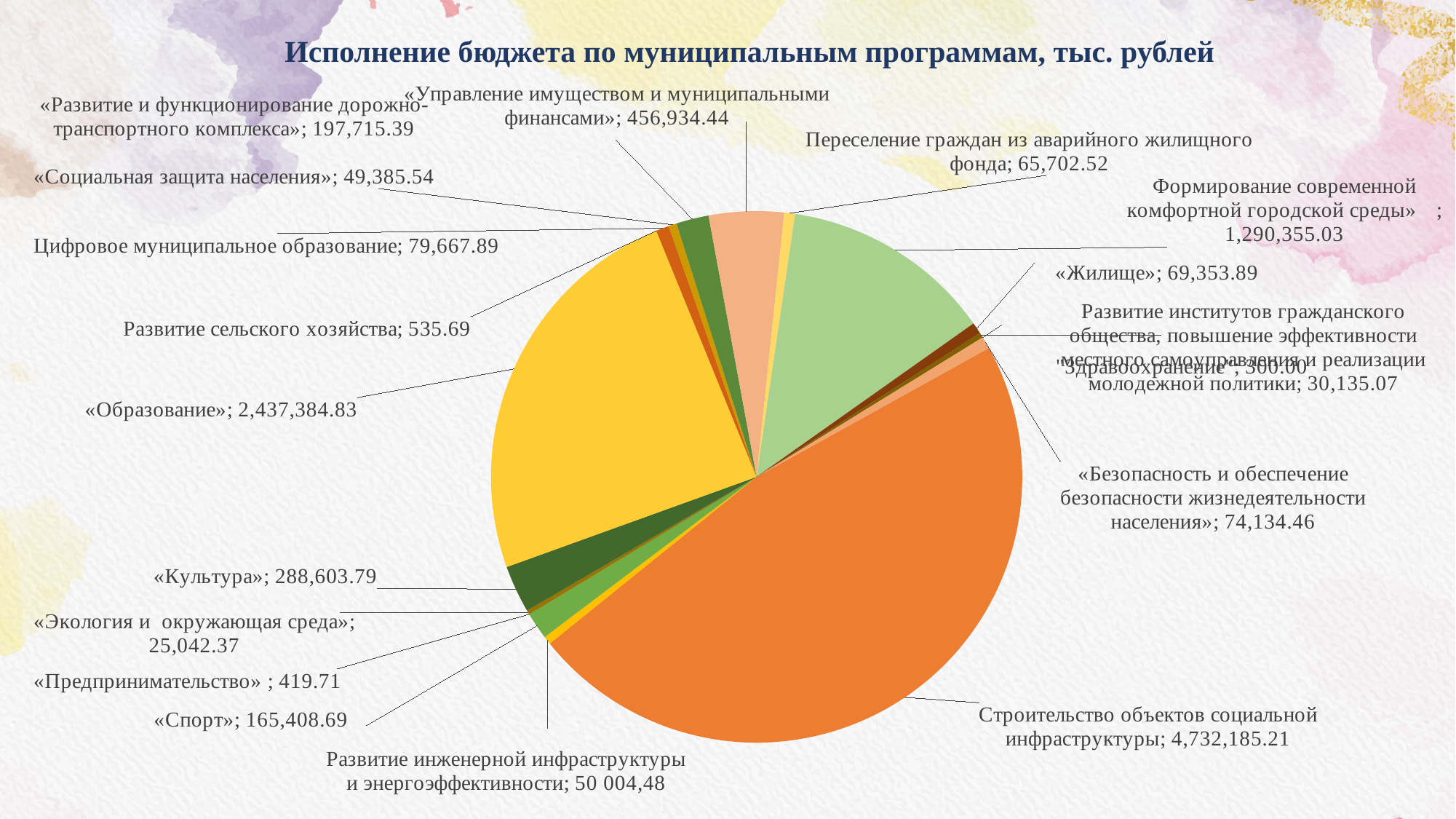
What is the difference between the values for «Образование» and «Культура»? 2,148,781.04 What is the value for «Управление имуществом и муниципальными финансами»? 456,934.44 Which is larger: the value for «Образование» or for Формирование современной комфортной городской среды? «Образование» What type of chart is shown on the slide? Pie chart What is the difference between the values for «Спорт» and «Социальная защита населения»? 116,023.15 What is the title of the chart? Исполнение бюджета по муниципальным программам, тыс. рублей What is the value for «Спорт»? 165,408.69 What is the value for Строительство объектов социальной инфраструктуры? 4,732,185.21 Which program has the largest value in the pie chart? Строительство объектов социальной инфраструктуры What is the value for Цифровое муниципальное образование? 79,667.89 What is the value for «Образование»? 2,437,384.83 What is the value for «Культура»? 288,603.79